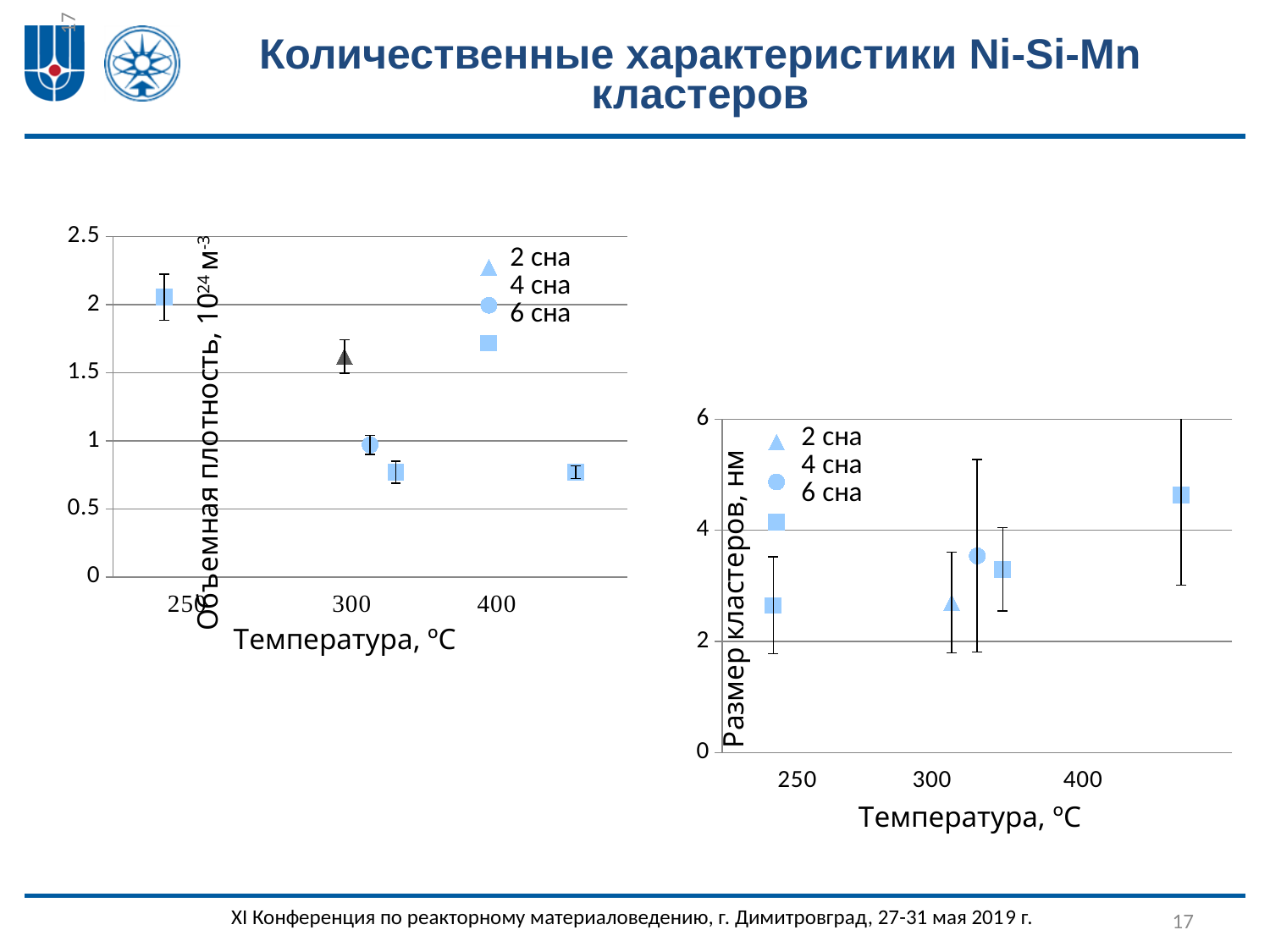
In the left chart, is the value of the square point near 450 °C greater or less than 1? less How many series does the legend of the right chart (Размер кластеров) list? 3 In the left chart, is the value of the point at 250 °C greater or less than 1.5? greater In the right chart, is the value of the square point near 450 °C greater or less than 4? greater What kind of chart is the left chart (Объемная плотность)? scatter chart In the left chart, do the plotted values rise or fall as temperature increases? fall What is the y-axis title of the right chart? Размер кластеров, нм What are the legend entries of the left chart? 2 сна, 4 сна, 6 сна How many data points are plotted in the right chart? 5